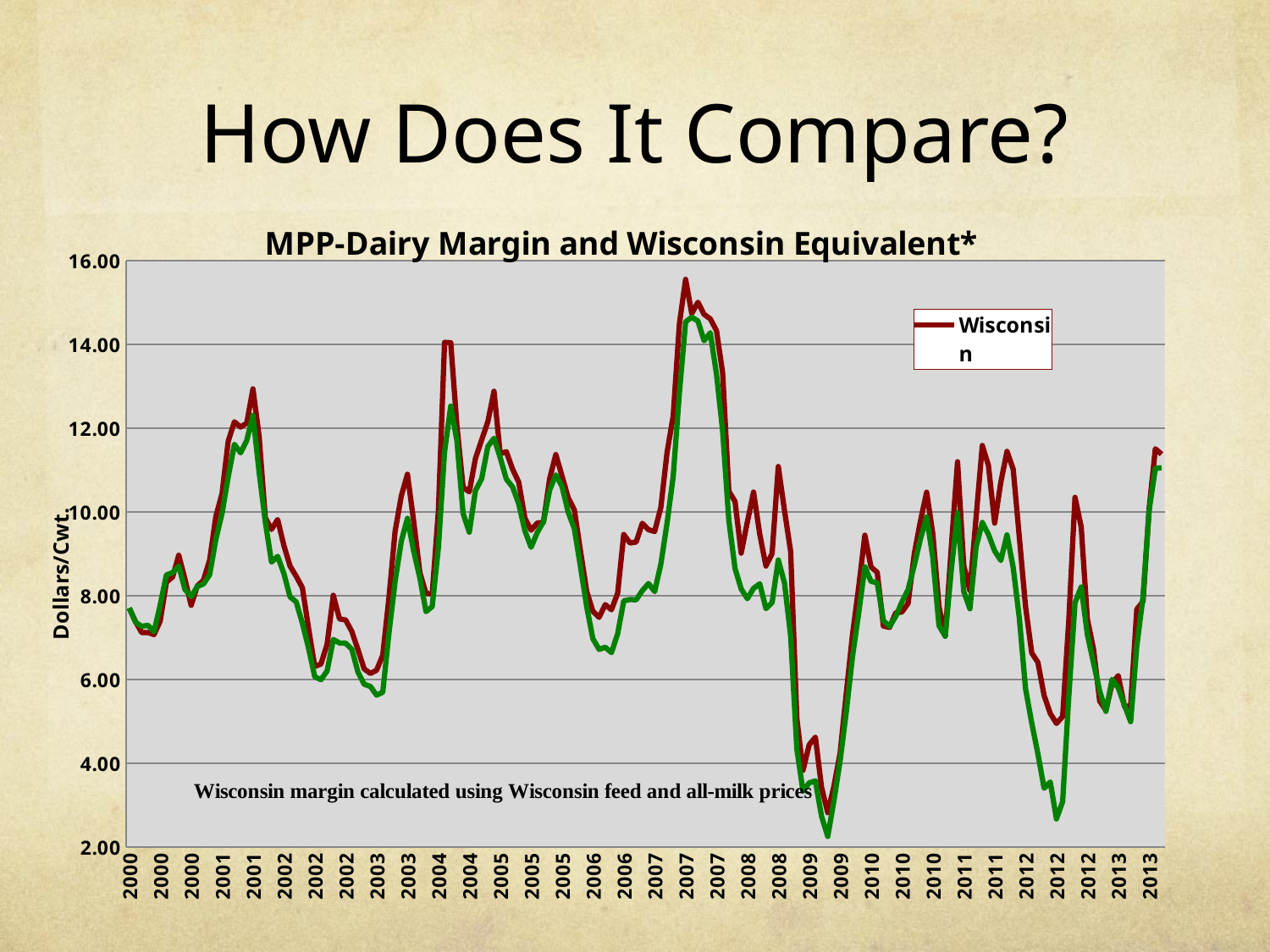
At the 2009 low point, which line drops to the lower value, the Wisconsin line or the green line? the green line Is the peak value of the Wisconsin line in 2007 greater or less than 14.00? greater Is the lowest value of the Wisconsin line in 2009 greater or less than 6.00? less What is the label on the vertical axis of the chart? Dollars/Cwt. What is the highest value shown on the vertical axis? 16.00 What is the title of the chart? MPP-Dairy Margin and Wisconsin Equivalent* Is the lowest value of the green line in 2009 greater or less than 4.00? less Do the values of the Wisconsin line rise or fall from the 2007 peak into 2009? fall At the 2007 peak, which line reaches the higher value, the Wisconsin line or the green line? Wisconsin What kind of chart is shown on the slide? line chart